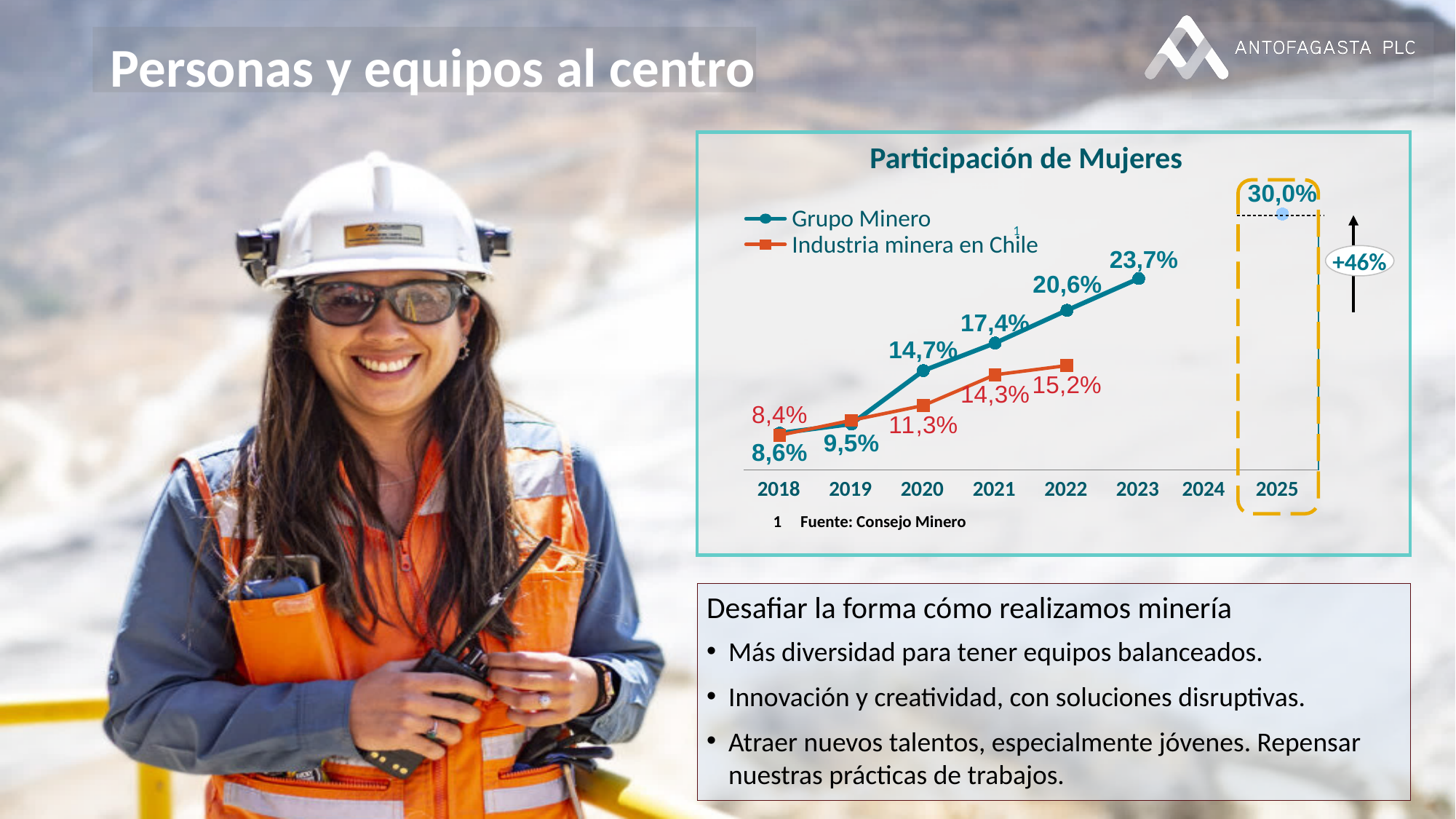
What is the Grupo Minero value for 2023 in the "Participación de Mujeres" chart? 23,7% By how much did the Grupo Minero value increase from 2018 to 2023? 15,1% What is the difference between the Grupo Minero and Industria minera en Chile values in 2022? 5,4% In 2021, which series has the higher value, Grupo Minero or Industria minera en Chile? Grupo Minero What is the Grupo Minero value for 2018? 8,6% What value is shown for Grupo Minero in 2025? 30,0% What percentage increase is annotated next to the 2025 target in the chart? +46% What is the Industria minera en Chile value for 2022? 15,2% What type of chart is shown under the title "Participación de Mujeres"? Line chart Does the Grupo Minero series rise or fall from 2018 to 2023? Rise Between 2018 and 2023, in which year is the Grupo Minero value lowest? 2018 How many series does the legend of the "Participación de Mujeres" chart list? 2